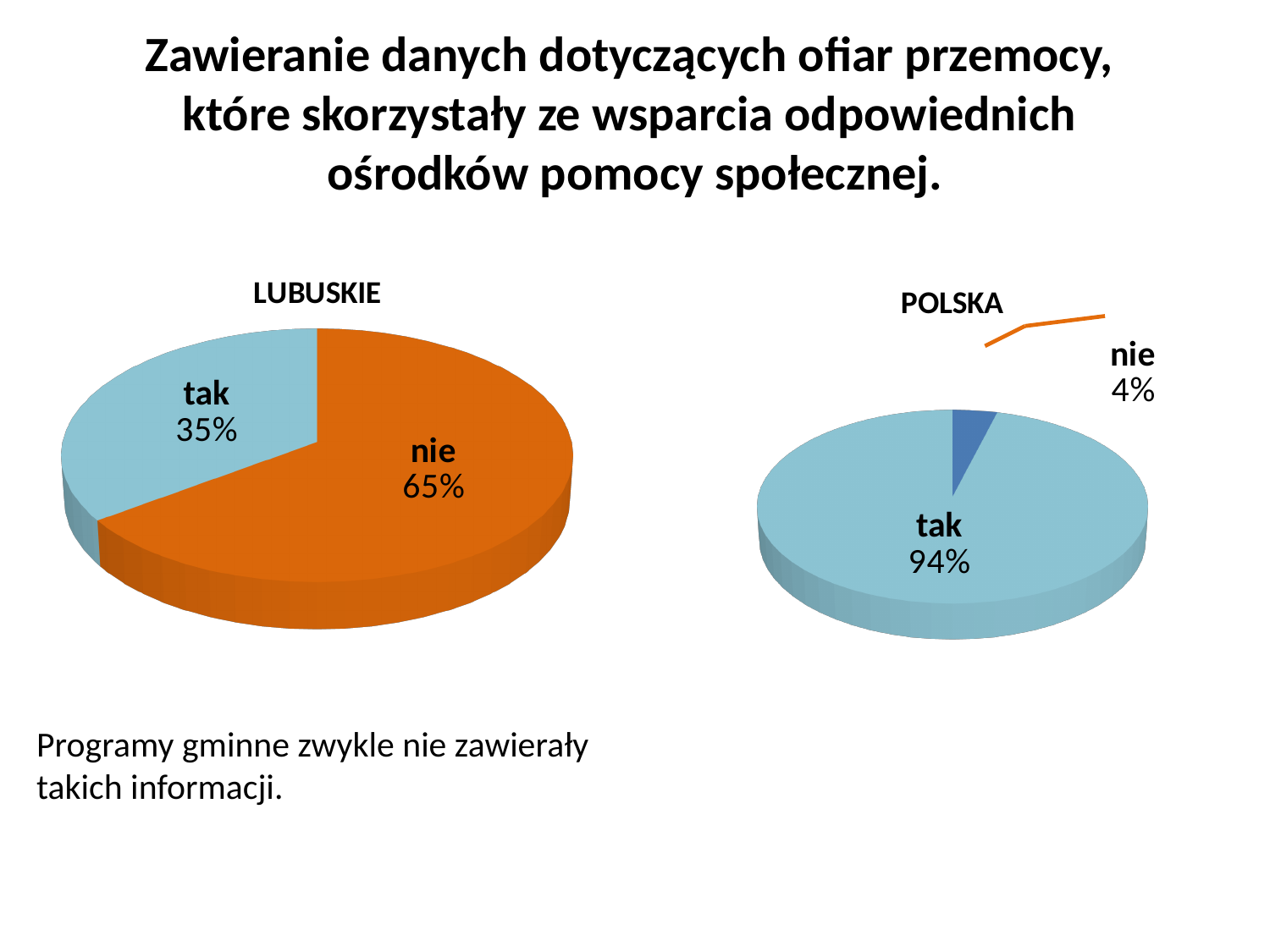
What is the title of the chart on the right side of the slide? POLSKA How many slices does the LUBUSKIE chart have? 2 In the POLSKA chart, which slice is the smallest? nie In the POLSKA chart, what share is labelled "tak"? 94% Which chart has the larger "tak" share, LUBUSKIE or POLSKA? POLSKA In the LUBUSKIE chart, which slice is the largest? nie In the LUBUSKIE chart, what is the difference between the "nie" and "tak" shares? 30% In the POLSKA chart, what share is labelled "nie"? 4% In the LUBUSKIE chart, what share is labelled "nie"? 65% In the LUBUSKIE chart, what share is labelled "tak"? 35% What type of chart is the POLSKA chart? pie chart In the POLSKA chart, what is the difference between the "tak" and "nie" shares? 90%